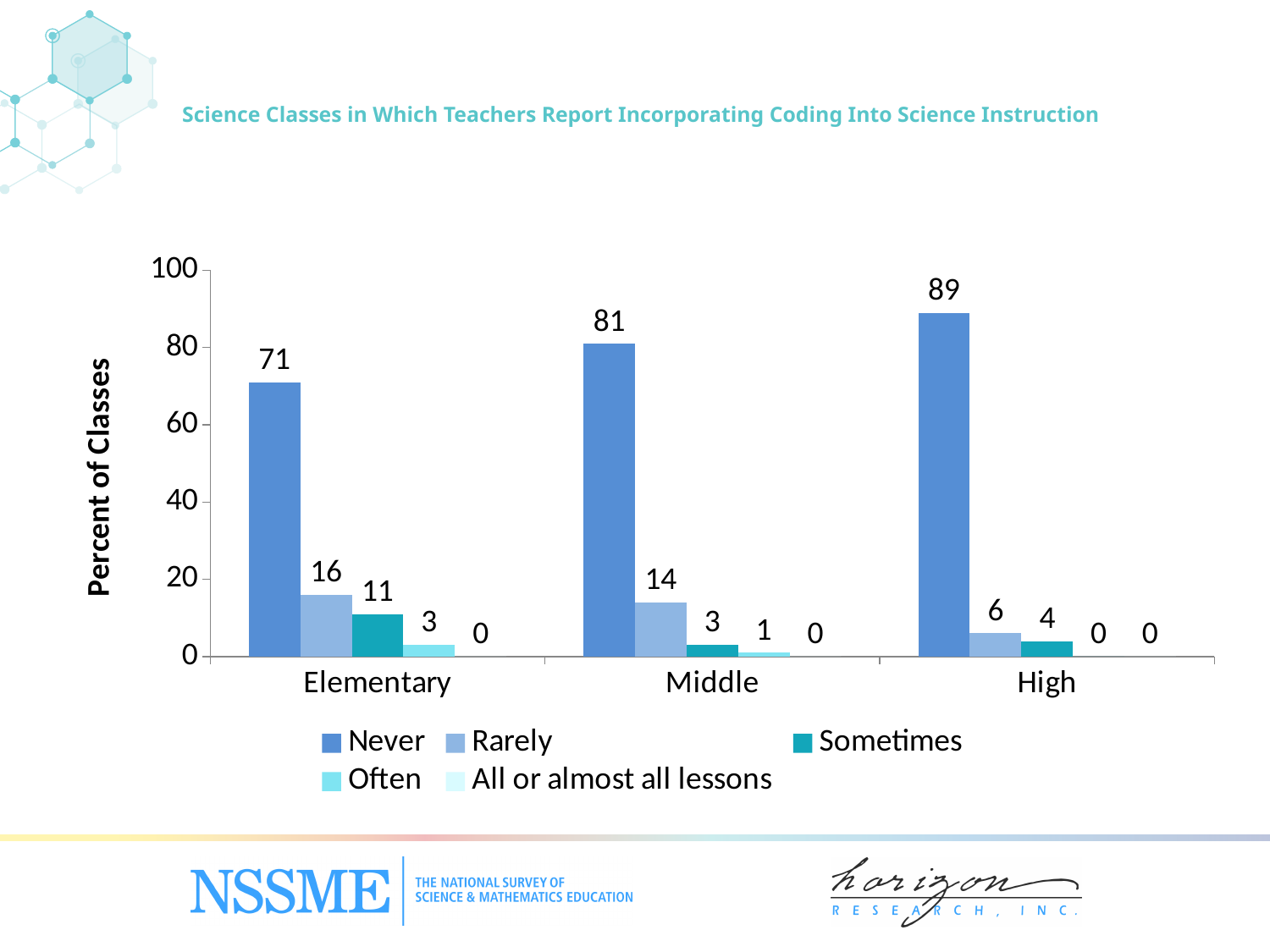
What is the difference between the 'Never' values for High and Elementary classes? 18 What is the label on the vertical axis? Percent of Classes What is the value for 'Sometimes' in High school classes? 4 How many grade-level categories are shown on the x axis? 3 What kind of chart is shown on the slide? Bar chart What percent of Elementary science classes report 'Never' incorporating coding? 71 Which grade level has the highest value for 'Never'? High Which is larger: the 'Sometimes' value for Elementary or for Middle? Elementary How many series does the legend list? 5 Which grade level has the lowest value for 'Rarely'? High Is the 'Never' value for Middle school classes greater or less than 60? greater What is the value for 'Rarely' in Middle school classes? 14